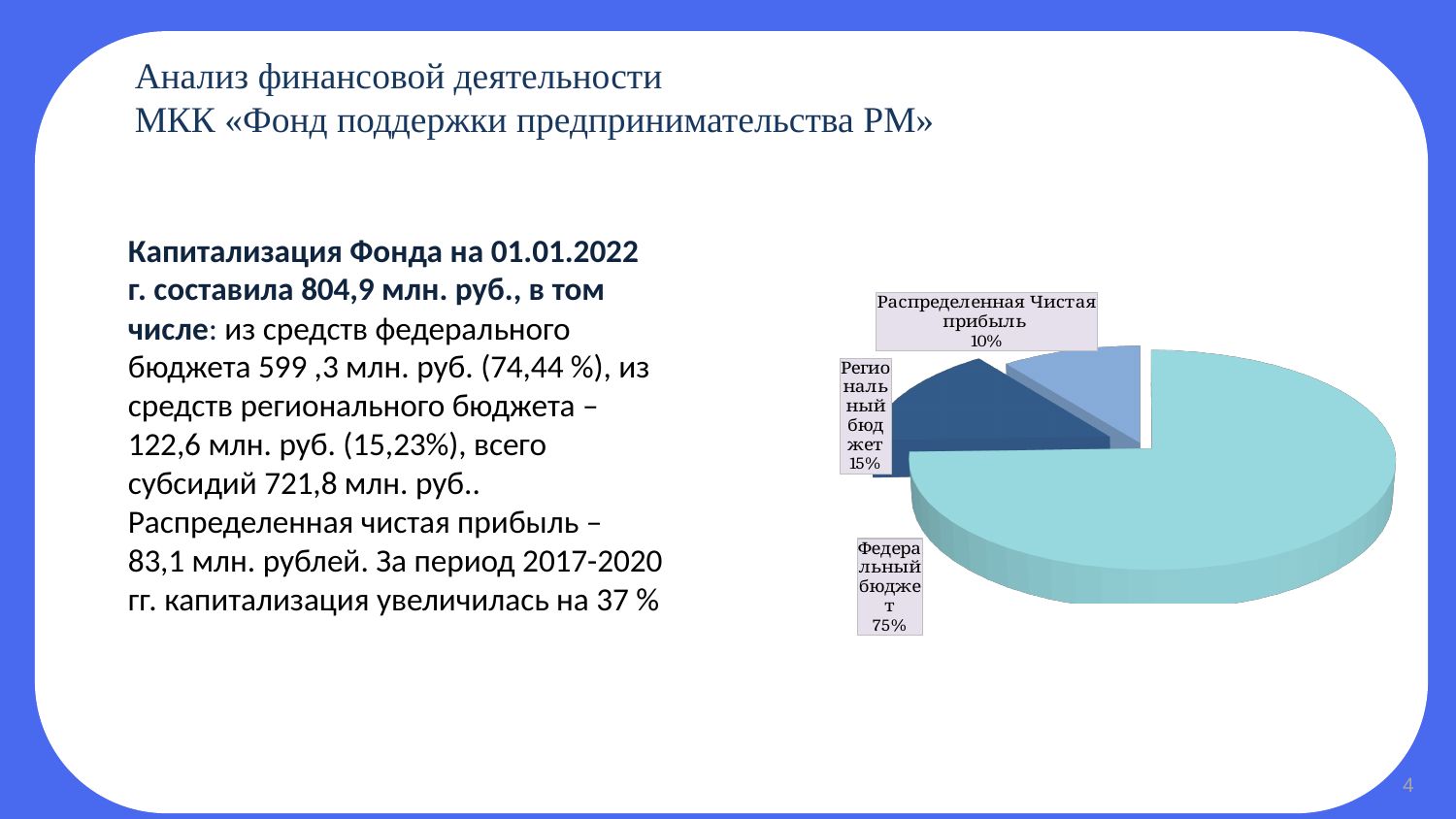
What is the difference in percentage points between the "Региональный бюджет" and "Распределенная Чистая прибыль" slices? 5 Which is larger in the pie chart: "Региональный бюджет" or "Распределенная Чистая прибыль"? Региональный бюджет What kind of chart is shown on the slide? Pie chart What is the difference in percentage points between the "Федеральный бюджет" and "Региональный бюджет" slices? 60 What share of the pie does "Федеральный бюджет" represent? 75% Which slice of the pie chart is the smallest? Распределенная Чистая прибыль Is the share for "Федеральный бюджет" greater or less than 50%? greater What share of the pie does "Региональный бюджет" represent? 15% What colour is the "Федеральный бюджет" slice in the pie chart? Light turquoise Which slice of the pie chart is the largest? Федеральный бюджет How many slices does the pie chart have? 3 What share of the pie does "Распределенная Чистая прибыль" represent? 10%